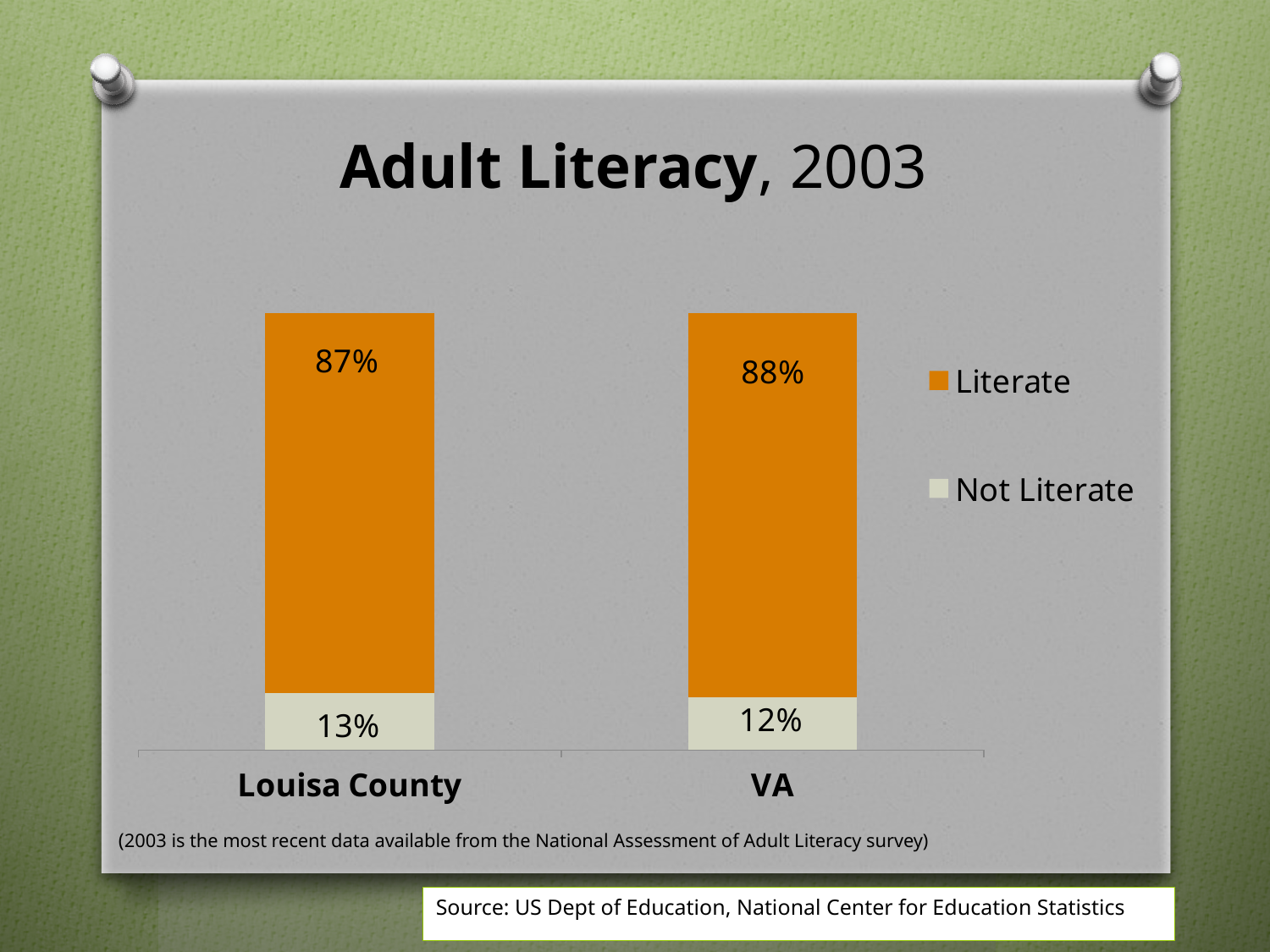
How many categories are shown on the x axis? 2 Which series is shown in orange? Literate What is the Literate value for Louisa County? 87% What is the Not Literate value for VA? 12% What is the difference between the Literate values for VA and Louisa County? 1% What is the total of the stacked bar for Louisa County? 100% How many series does the legend list? 2 What is the title of the chart? Adult Literacy, 2003 Which category has the higher Not Literate value, Louisa County or VA? Louisa County What is the Not Literate value for Louisa County? 13% What is the Literate value for VA? 88% What kind of chart is shown on the slide? Stacked bar chart